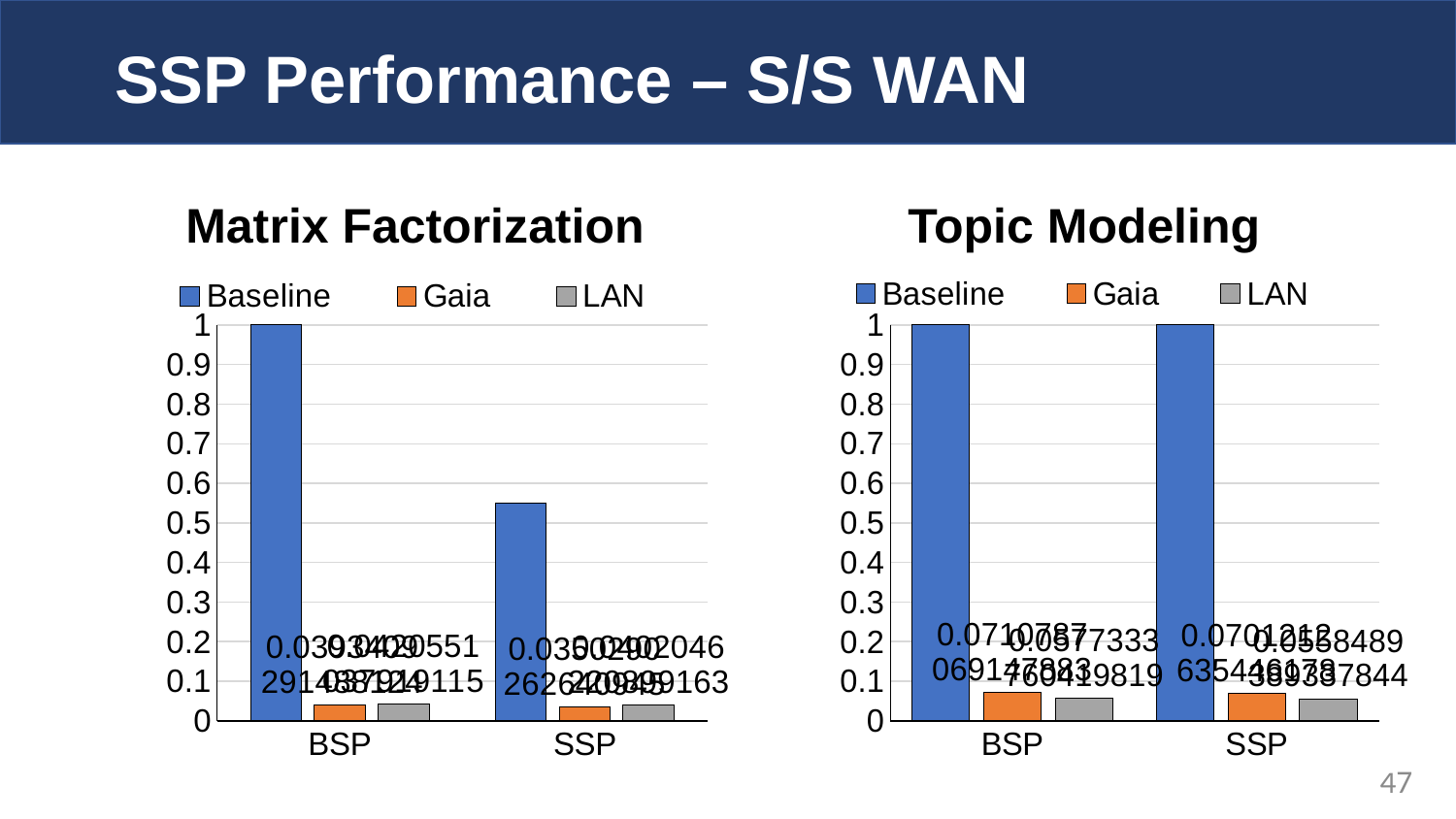
In the Matrix Factorization chart, does the Baseline value rise or fall from BSP to SSP? fall In the Matrix Factorization chart, which category has the higher Baseline value, BSP or SSP? BSP What are the three legend entries in the Topic Modeling chart? Baseline, Gaia, LAN How many series does the legend of the Topic Modeling chart list? 3 In the Topic Modeling chart, what is the Baseline value for BSP? 1 How many categories are shown on the x axis of the Matrix Factorization chart? 2 In the Matrix Factorization chart, what is the Baseline value for BSP? 1 In the Matrix Factorization chart, is the Gaia value for BSP greater or less than 0.1? less What kind of chart is the Matrix Factorization chart? bar chart In the Matrix Factorization chart, is the Baseline value for SSP greater or less than 0.5? greater In the Matrix Factorization chart, is the Baseline value for SSP greater or less than 0.6? less